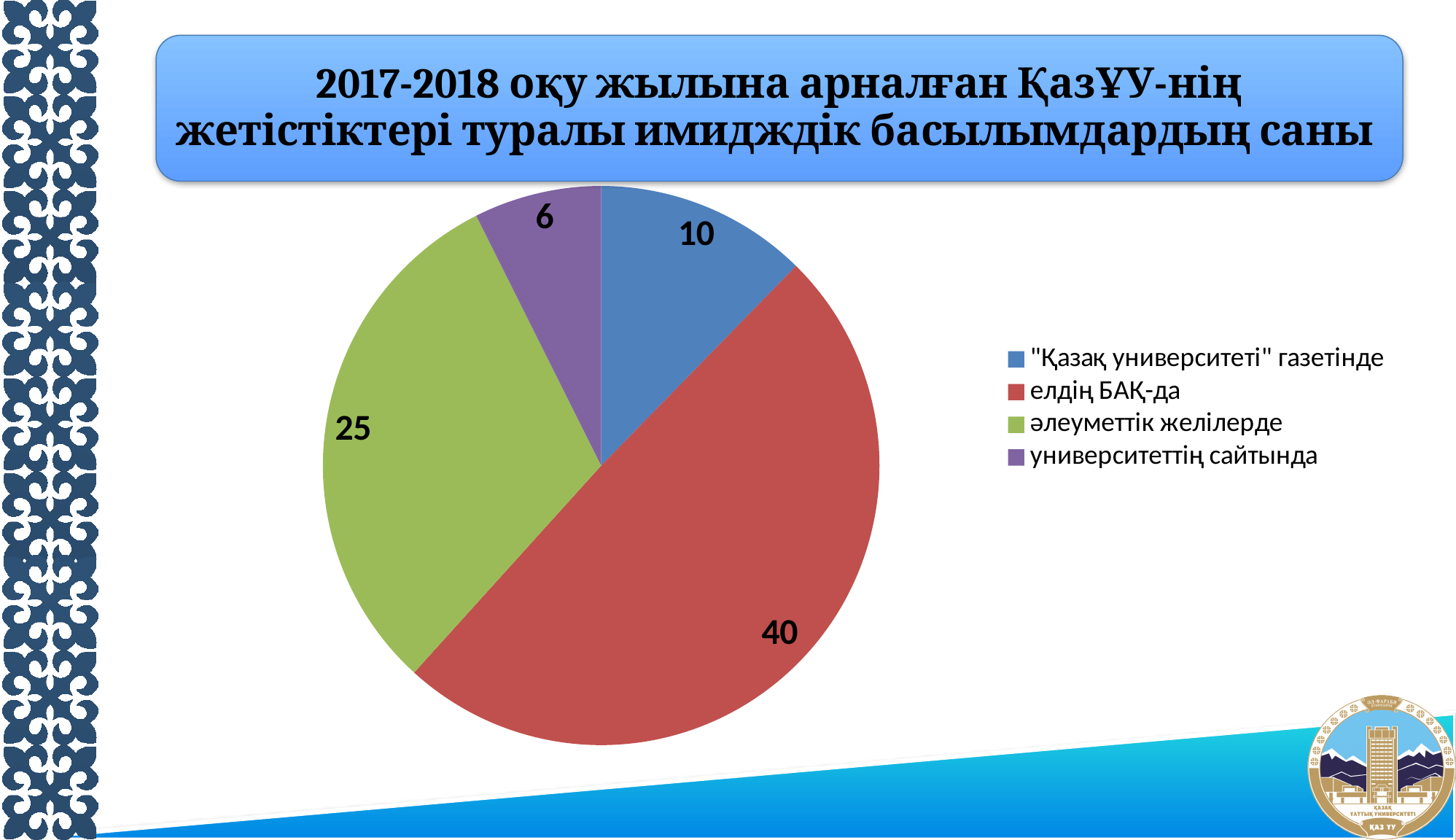
What is the difference between the values for елдің БАҚ-да and әлеуметтік желілерде? 15 Which is larger, the value for әлеуметтік желілерде or the value for "Қазақ университеті" газетінде? әлеуметтік желілерде What is the value for әлеуметтік желілерде? 25 What is the difference between the values for "Қазақ университеті" газетінде and университеттің сайтында? 4 Which category has the smallest slice of the pie? университеттің сайтында What is the value for елдің БАҚ-да? 40 What colour is the slice for әлеуметтік желілерде? green What is the value for университеттің сайтында? 6 What is the value for "Қазақ университеті" газетінде? 10 How many categories does the pie chart have? 4 Which category has the largest slice of the pie? елдің БАҚ-да What kind of chart is shown on the slide? pie chart